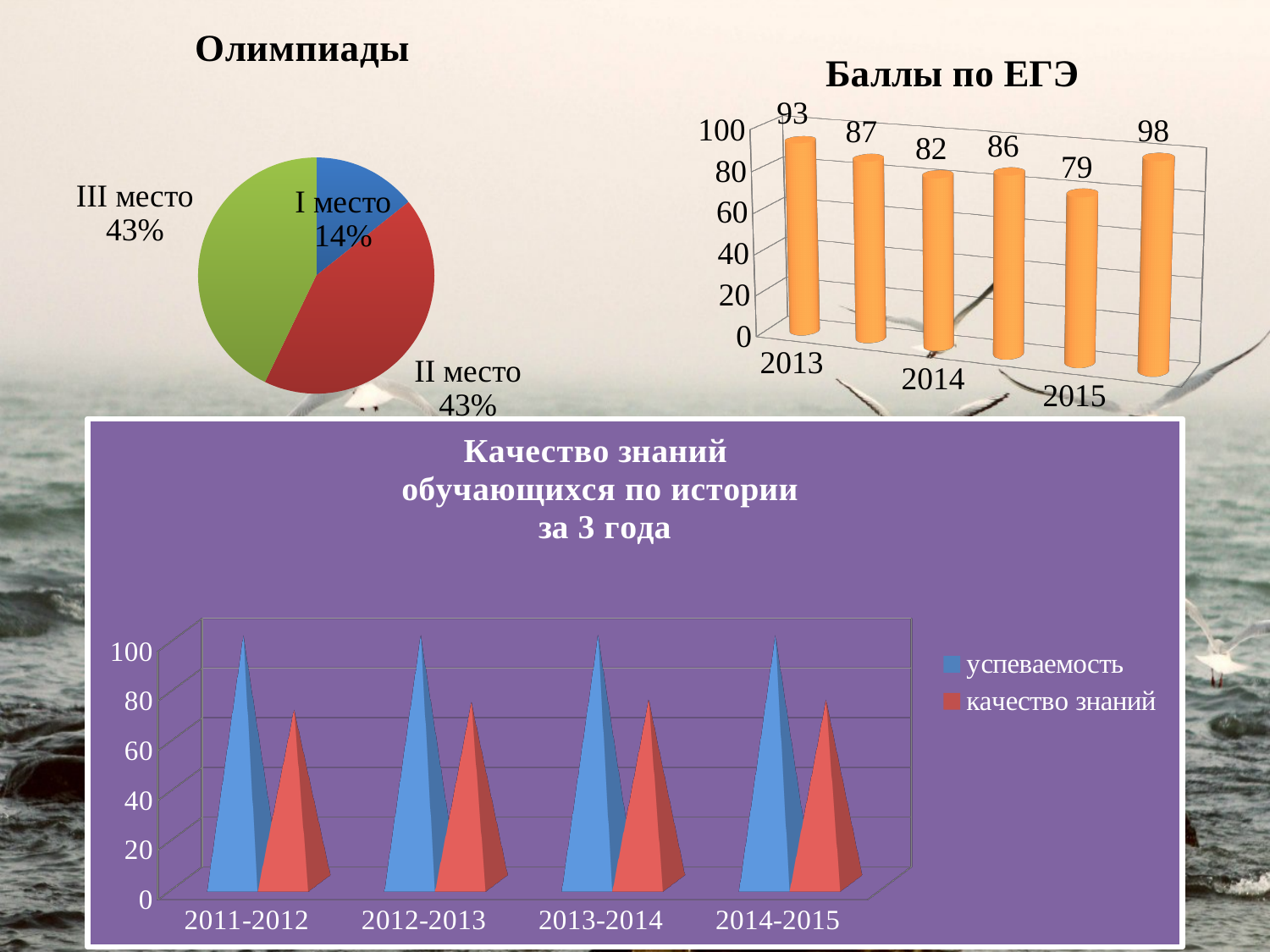
How many slices does the pie chart titled "Олимпиады" have? 3 In the chart titled "Баллы по ЕГЭ", what is the value of the leftmost bar? 93 What kind of chart is the chart titled "Баллы по ЕГЭ"? Bar chart In the chart titled "Баллы по ЕГЭ", what is the lowest value shown? 79 In the chart titled "Качество знаний обучающихся по истории за 3 года", is the value for "качество знаний" in 2012-2013 greater or less than 60? greater In the chart titled "Баллы по ЕГЭ", what is the difference between the highest and lowest values? 19 How many bars are plotted in the chart titled "Баллы по ЕГЭ"? 6 In the pie chart titled "Олимпиады", what share does "I место" have? 14% In the chart titled "Баллы по ЕГЭ", what is the highest value shown? 98 In the chart titled "Качество знаний обучающихся по истории за 3 года", which series is larger in 2013-2014, "успеваемость" or "качество знаний"? успеваемость In the pie chart titled "Олимпиады", what share does "III место" have? 43% How many series does the legend list in the chart titled "Качество знаний обучающихся по истории за 3 года"? 2